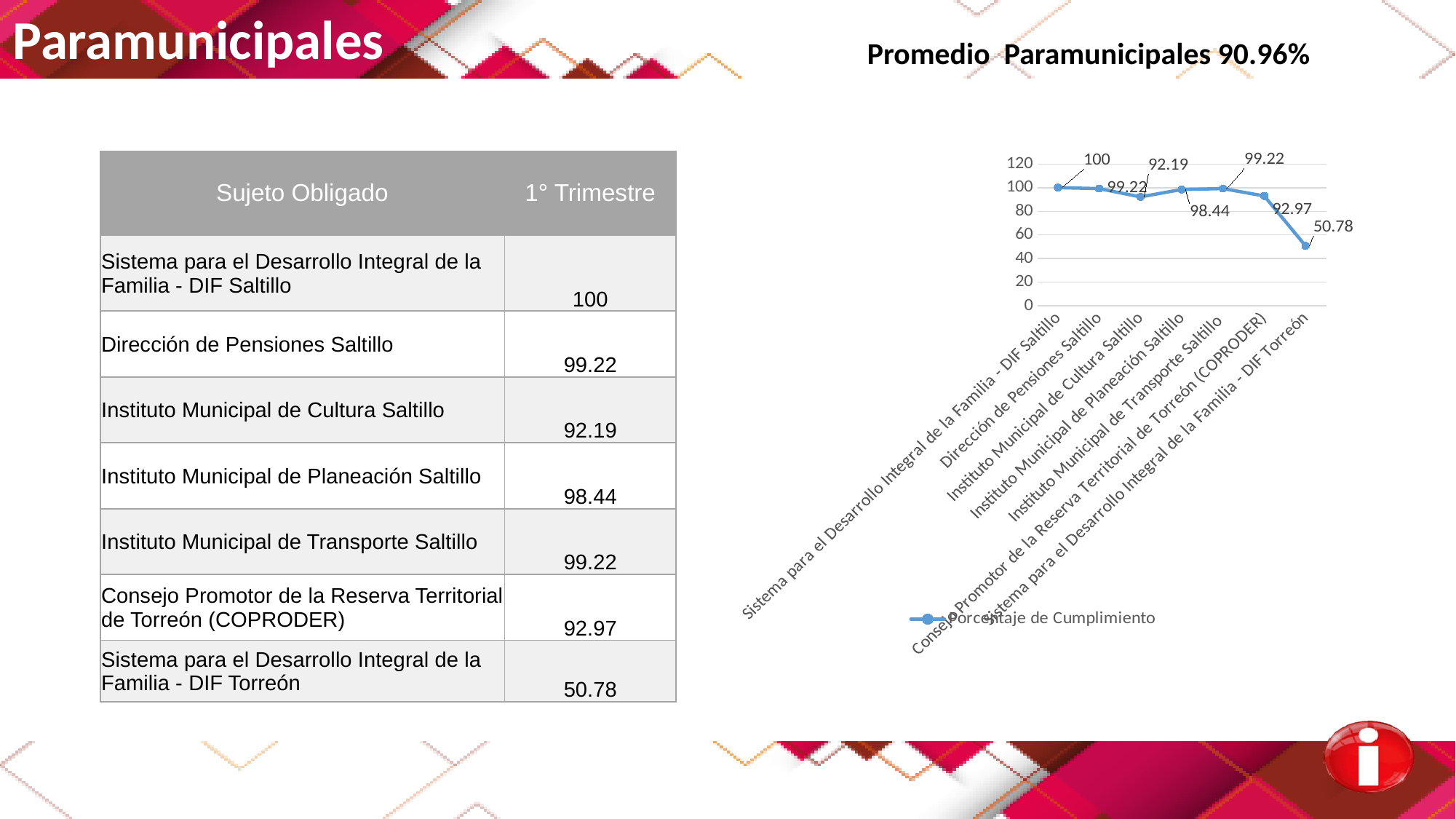
What type of chart is shown on the slide? line chart What is the value for Instituto Municipal de Cultura Saltillo in the chart? 92.19 What is the value for Instituto Municipal de Planeación Saltillo in the chart? 98.44 What is the value for Sistema para el Desarrollo Integral de la Familia - DIF Torreón in the chart? 50.78 Which category has the lowest value in the chart? Sistema para el Desarrollo Integral de la Familia - DIF Torreón What is the difference between the values for Consejo Promotor de la Reserva Territorial de Torreón (COPRODER) and Sistema para el Desarrollo Integral de la Familia - DIF Torreón? 42.19 What is the name of the series shown in the chart legend? Porcentaje de Cumplimiento Which is larger, the value for Instituto Municipal de Planeación Saltillo or the value for Instituto Municipal de Cultura Saltillo? Instituto Municipal de Planeación Saltillo How many categories are plotted on the x axis of the chart? 7 How many series does the chart legend list? 1 Which category has the highest value in the chart? Sistema para el Desarrollo Integral de la Familia - DIF Saltillo What is the value for Sistema para el Desarrollo Integral de la Familia - DIF Saltillo in the chart? 100